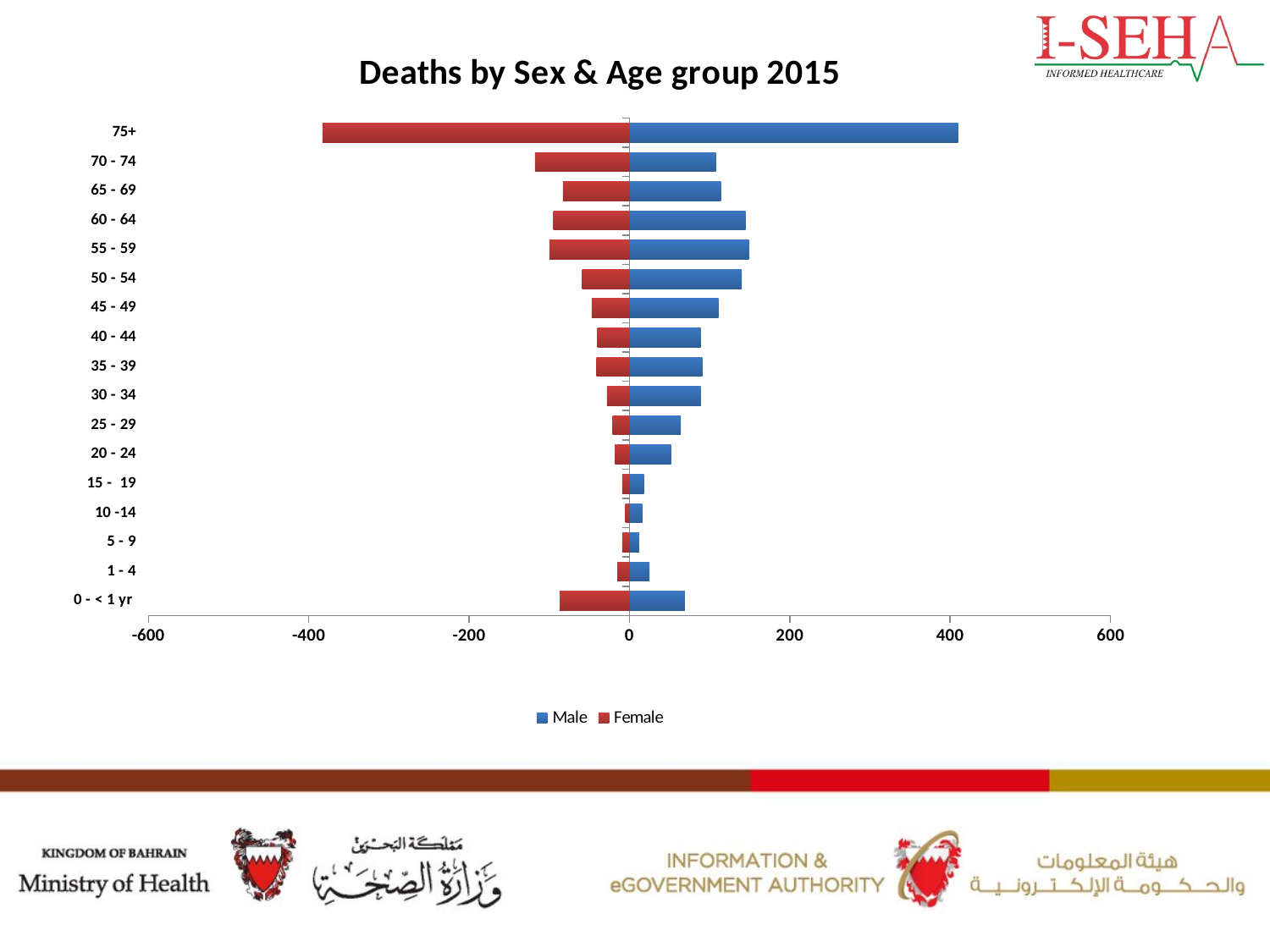
How many age group categories are shown on the chart? 17 Which age group has the longest Female bar? 75+ Which is larger, the Male value for 60 - 64 or the Male value for 25 - 29? 60 - 64 Is the Male value for 0 - < 1 yr greater or less than 100? less Is the Male value for 60 - 64 greater or less than 200? less Which is larger, the Male value for 75+ or the Male value for 70 - 74? 75+ What kind of chart is shown on the slide? bar chart Which colour represents the Female series? red Which age group has the highest Male value? 75+ What is the title of the chart? Deaths by Sex & Age group 2015 How many series does the legend list? 2